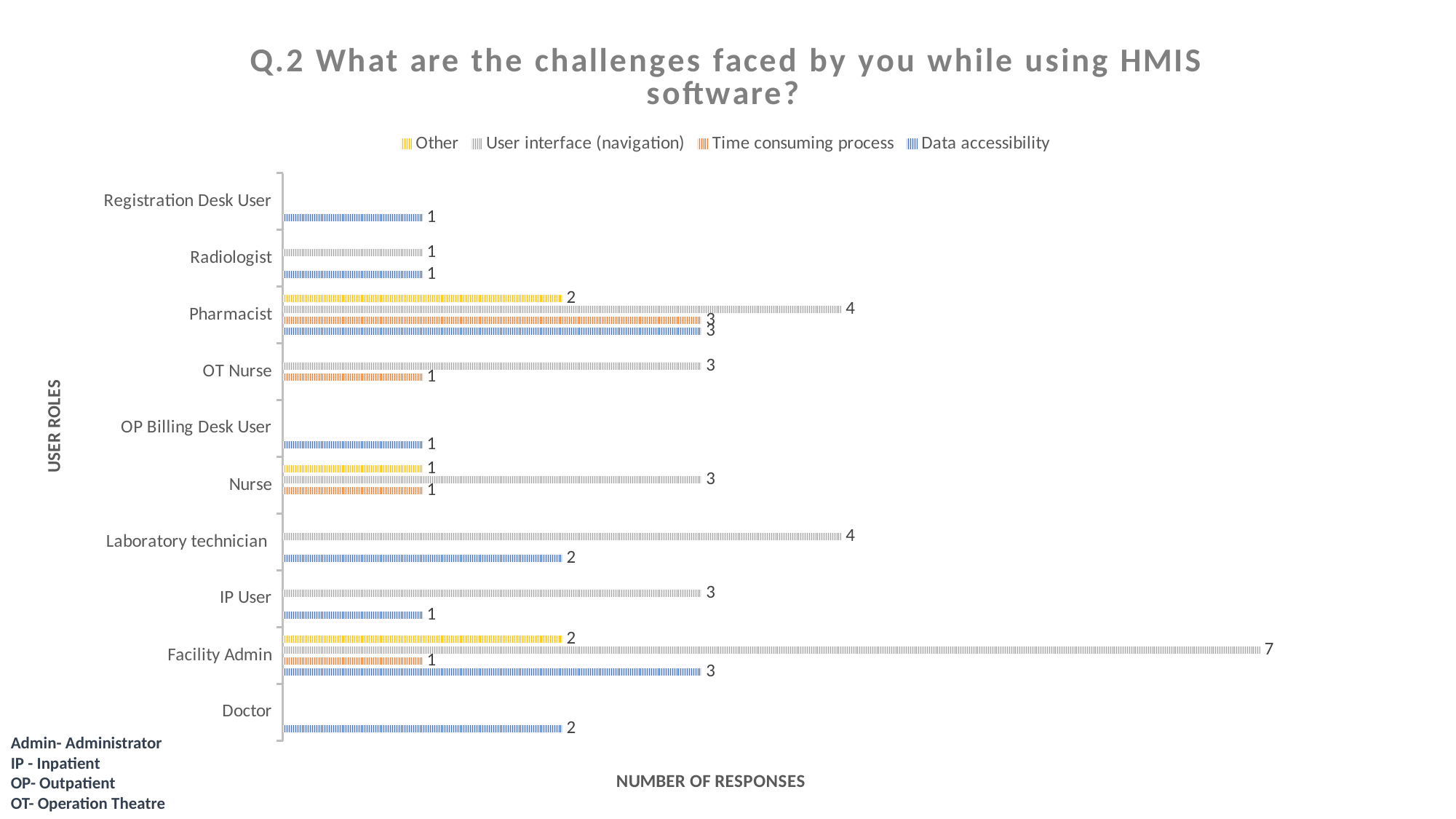
What type of chart is shown on the slide? Bar chart What is the difference between the User interface (navigation) responses for Facility Admin and for Pharmacist? 3 What is the total number of responses across all four series for Pharmacist? 12 How many user roles are shown on the y axis? 10 What is the number of responses for User interface (navigation) for Facility Admin? 7 What is the title of the chart? Q.2 What are the challenges faced by you while using HMIS software? Which user role has the highest number of responses for User interface (navigation)? Facility Admin How many series does the legend list? 4 Which is larger: the Data accessibility responses for Laboratory technician or for IP User? Laboratory technician What is the number of responses for Other for Pharmacist? 2 What is the number of responses for Data accessibility for Doctor? 2 What is the number of responses for Time consuming process for OT Nurse? 1